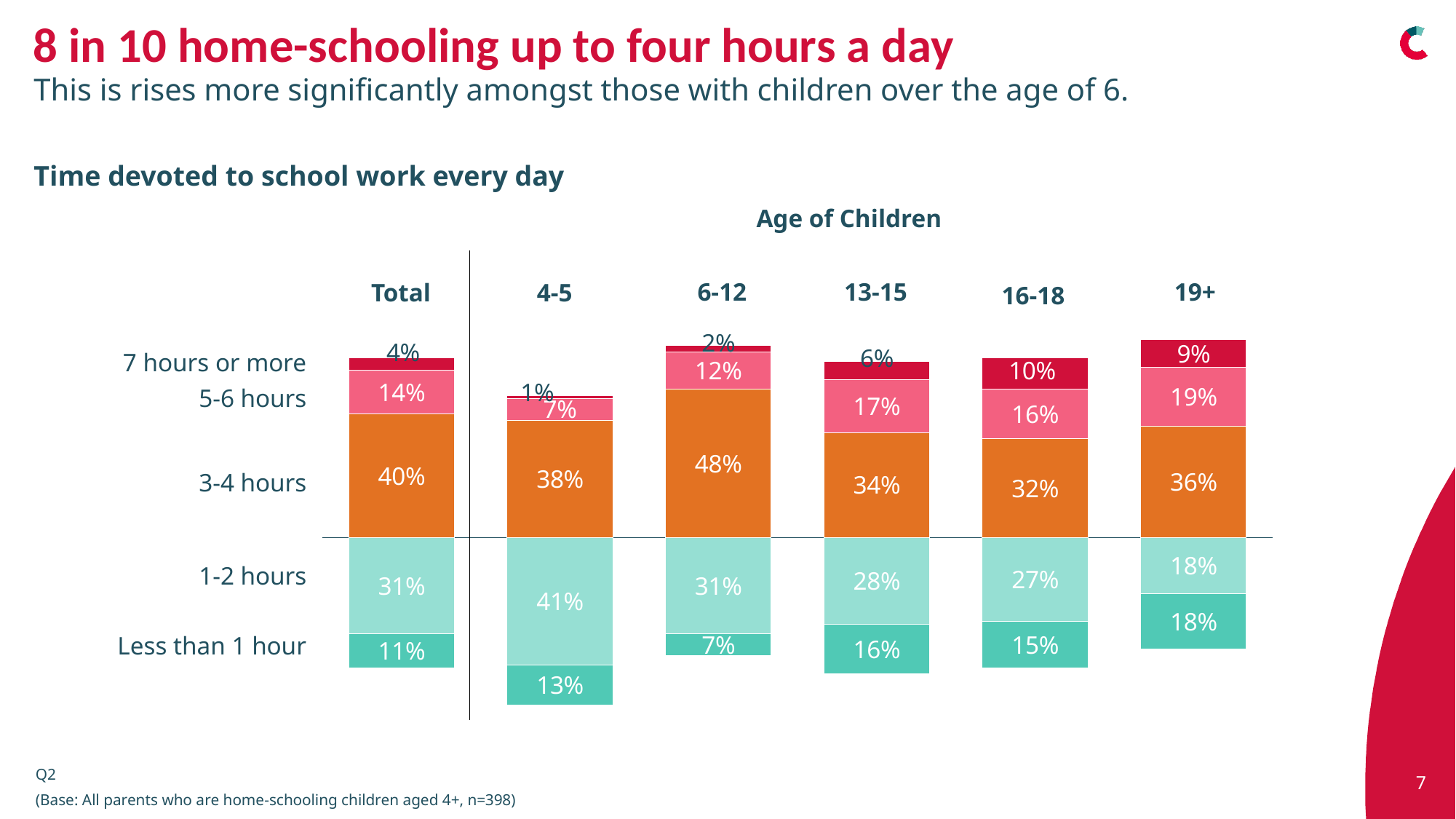
What type of chart is shown on the slide? Stacked bar chart What percentage of the 19+ age group spend 7 hours or more on school work? 9% What is the value for Less than 1 hour in the 6-12 age group? 7% Which age group has the highest value for 3-4 hours? 6-12 What is the title of the chart? Time devoted to school work every day Which is larger: the 1-2 hours value for 13-15 or for 16-18? 13-15 What percentage of the Total group devote 3-4 hours to school work every day? 40% How many age groups (excluding Total) are shown in the chart? 5 What is the difference between the 5-6 hours values for the 19+ group and the 4-5 group? 12% How many time categories are shown for each bar? 5 What is the value for 1-2 hours among parents with children aged 4-5? 41% Which age group has the lowest value for 7 hours or more? 4-5